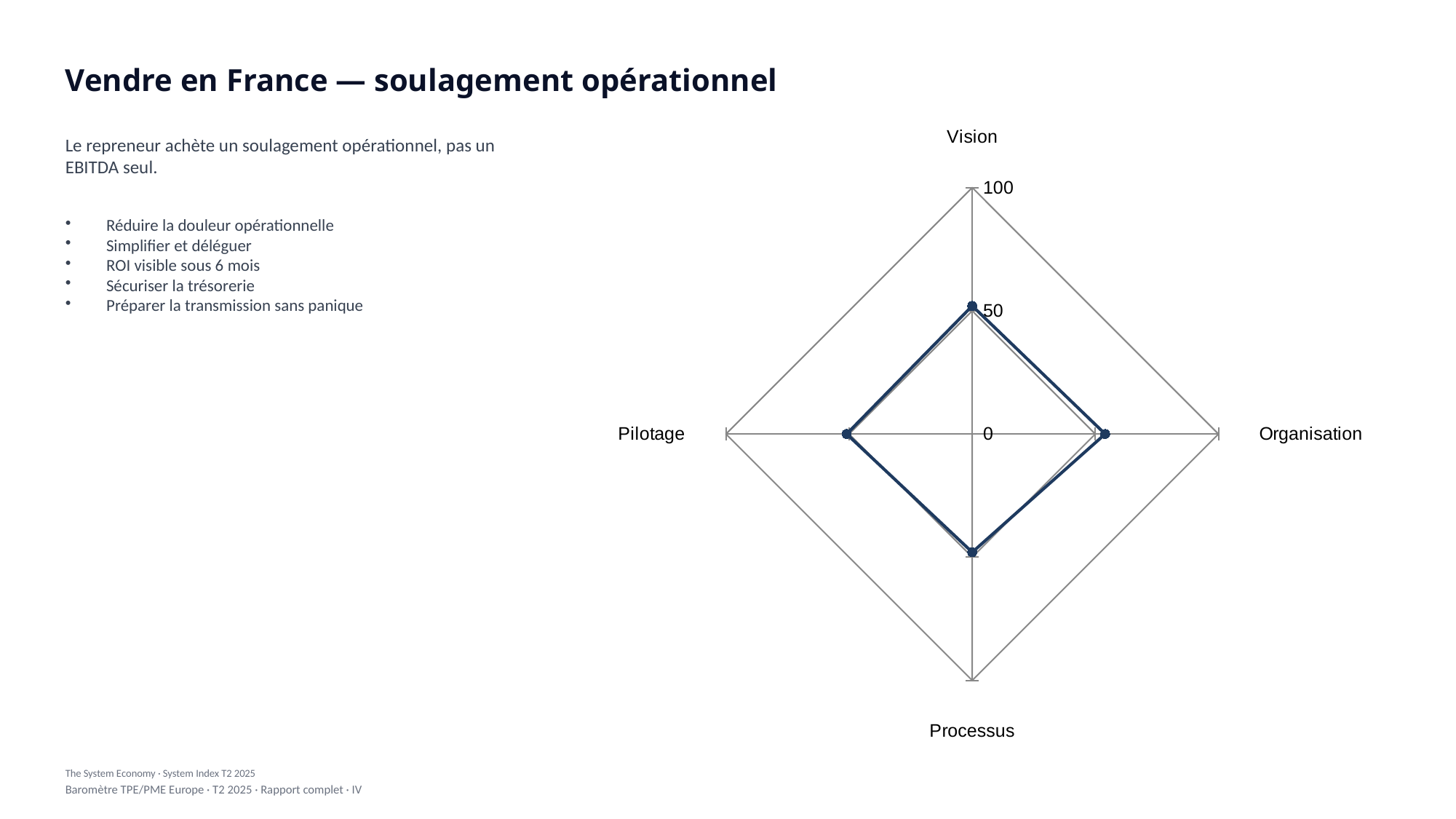
What is the maximum value shown on the radar chart's scale? 100 Is the value for Organisation greater or less than 100? less Is the value for Pilotage greater or less than 100? less Is the value for Vision greater or less than 100? less How many categories (axes) does the radar chart have? 4 Which category is labelled at the top of the radar chart? Vision What kind of chart is shown on the slide? radar chart